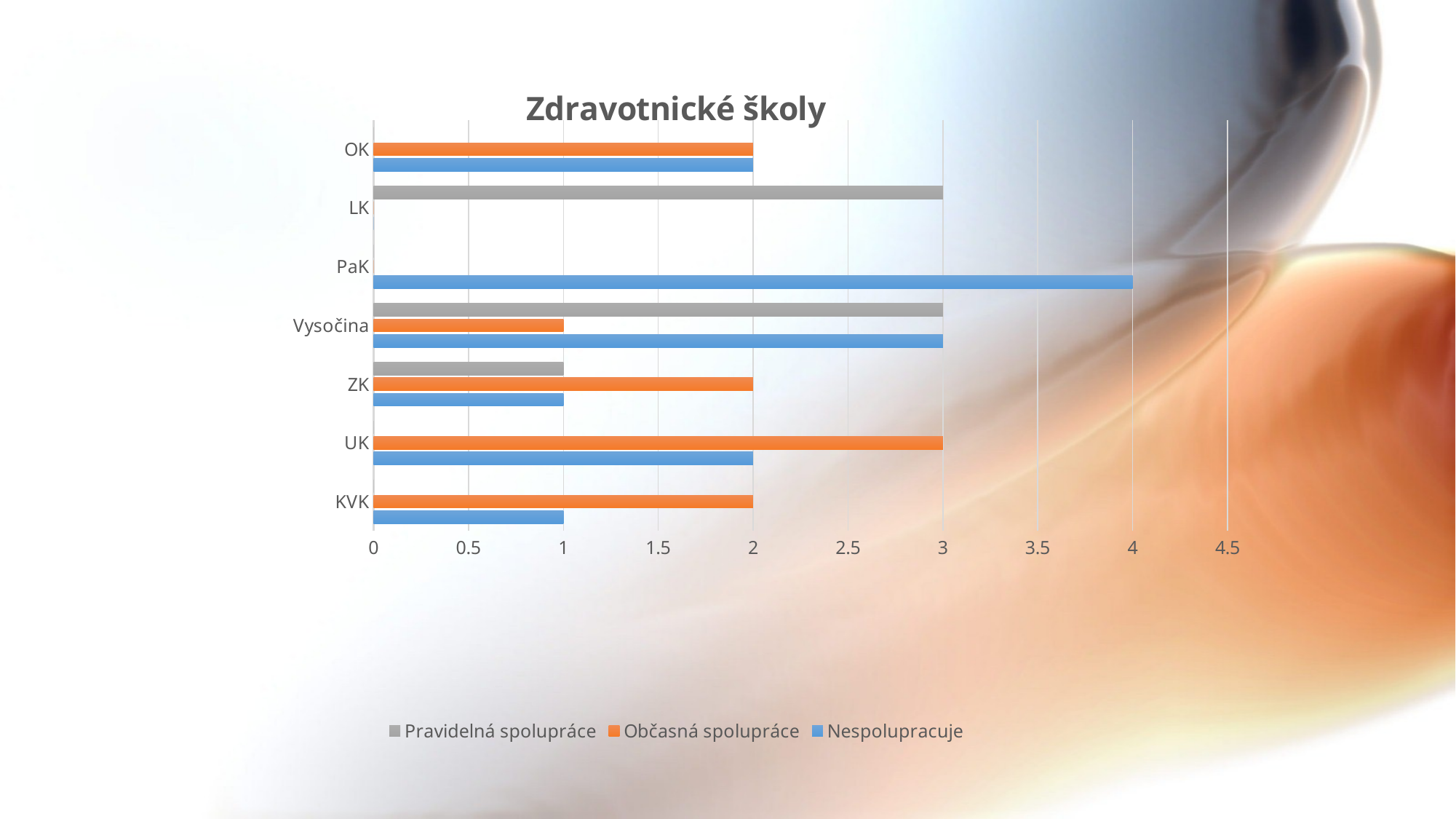
What is the value of Pravidelná spolupráce for LK? 3 How many categories are shown on the vertical axis? 7 Which is larger for ZK: Občasná spolupráce or Pravidelná spolupráce? Občasná spolupráce How many series does the legend list? 3 What is the value of Občasná spolupráce for Vysočina? 1 What kind of chart is shown on the slide? bar chart What is the title of the chart? Zdravotnické školy Which category has the highest value for Nespolupracuje? PaK What is the value of Občasná spolupráce for UK? 3 What is the value of Nespolupracuje for PaK? 4 What is the difference between the Nespolupracuje values for PaK and KVK? 3